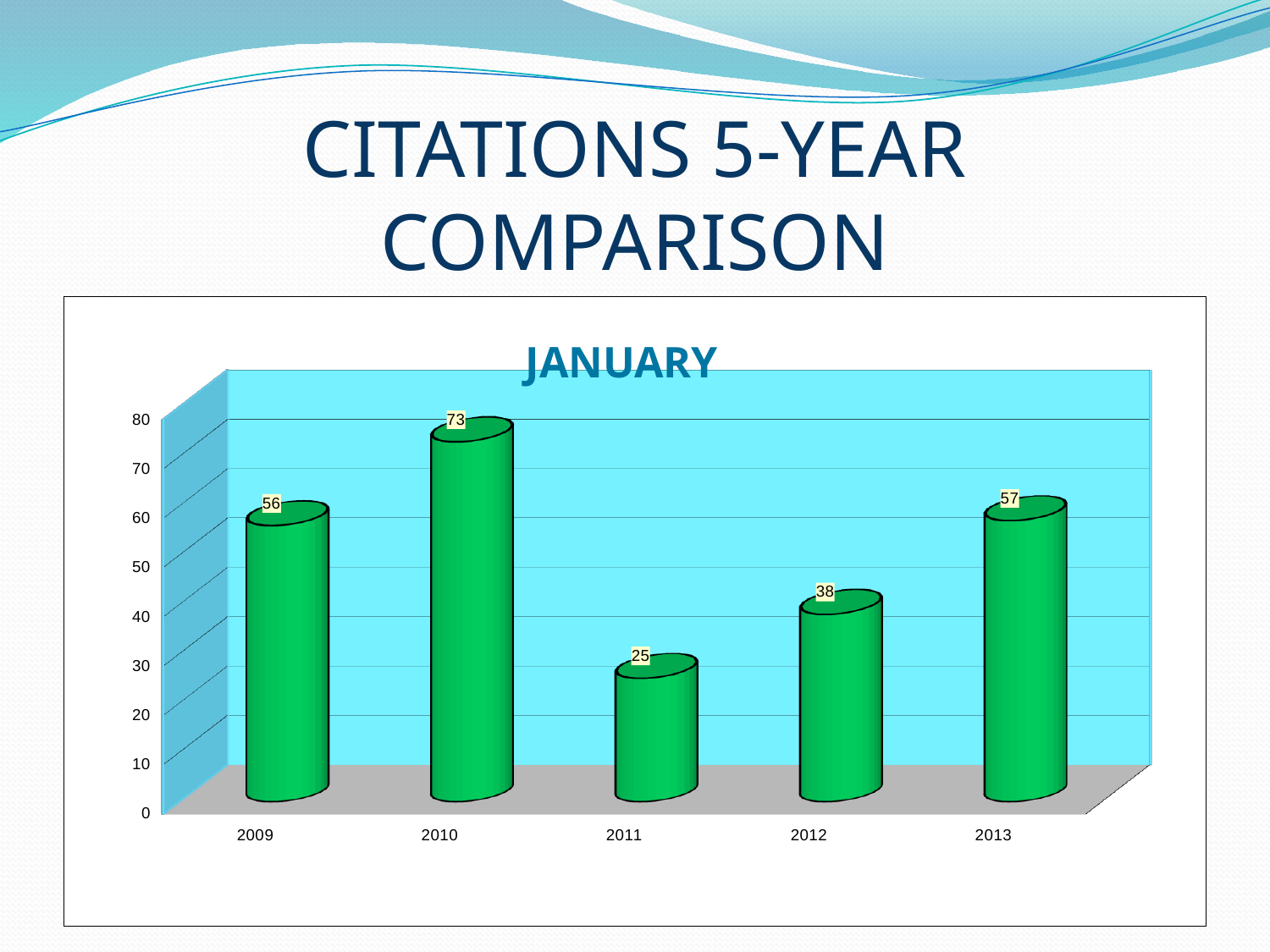
What kind of chart is this? bar chart What is the value for 2013? 57 What is the difference between the values for 2010 and 2011? 48 What is the value for 2010? 73 Is the value for 2012 greater or less than 40? less Which is larger, the value for 2009 or the value for 2012? 2009 What is the title of the chart? JANUARY How many years are shown on the x axis? 5 What is the difference between the values for 2013 and 2009? 1 Which year has the lowest value? 2011 What is the value for 2011? 25 Which year has the highest value? 2010